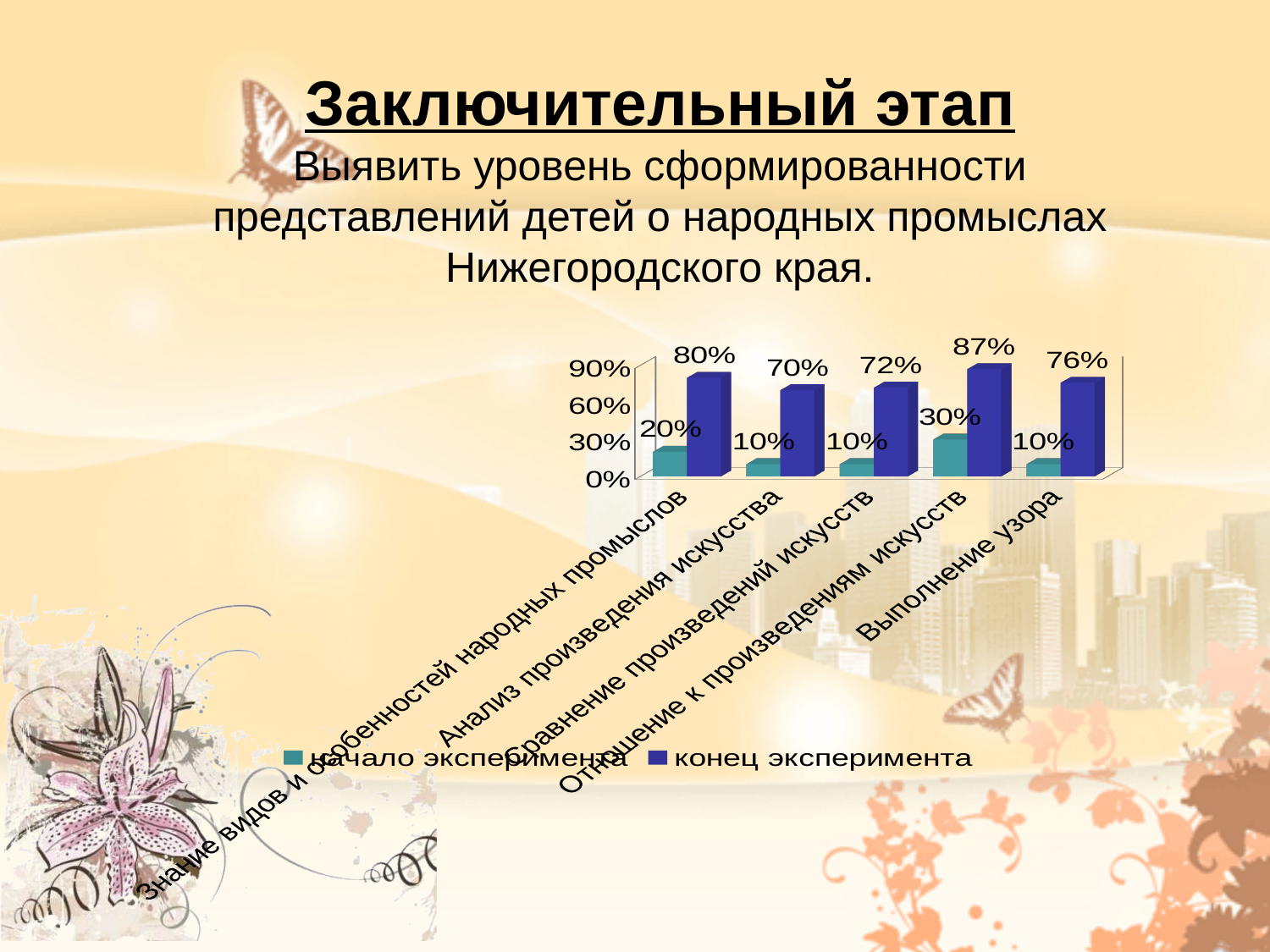
Which is larger: the "конец эксперимента" value for "Сравнение произведений искусств" or for "Выполнение узора"? Выполнение узора What is the difference between the "конец эксперимента" and "начало эксперимента" values for "Знание видов и особенностей народных промыслов"? 60% What kind of chart is shown on the slide? Bar chart What is the value for "Выполнение узора" in the "конец эксперимента" series? 76% Which category has the lowest value in the "конец эксперимента" series? Анализ произведения искусства What is the value for "Отношение к произведениям искусств" in the "начало эксперимента" series? 30% How many categories are shown on the x axis of the chart? 5 Which category has the highest value in the "конец эксперимента" series? Отношение к произведениям искусств How many series does the chart legend list? 2 What is the difference between the "конец эксперимента" and "начало эксперимента" values for "Выполнение узора"? 66% What is the value for "Анализ произведения искусства" in the "конец эксперимента" series? 70% What are the two series named in the chart legend? начало эксперимента and конец эксперимента